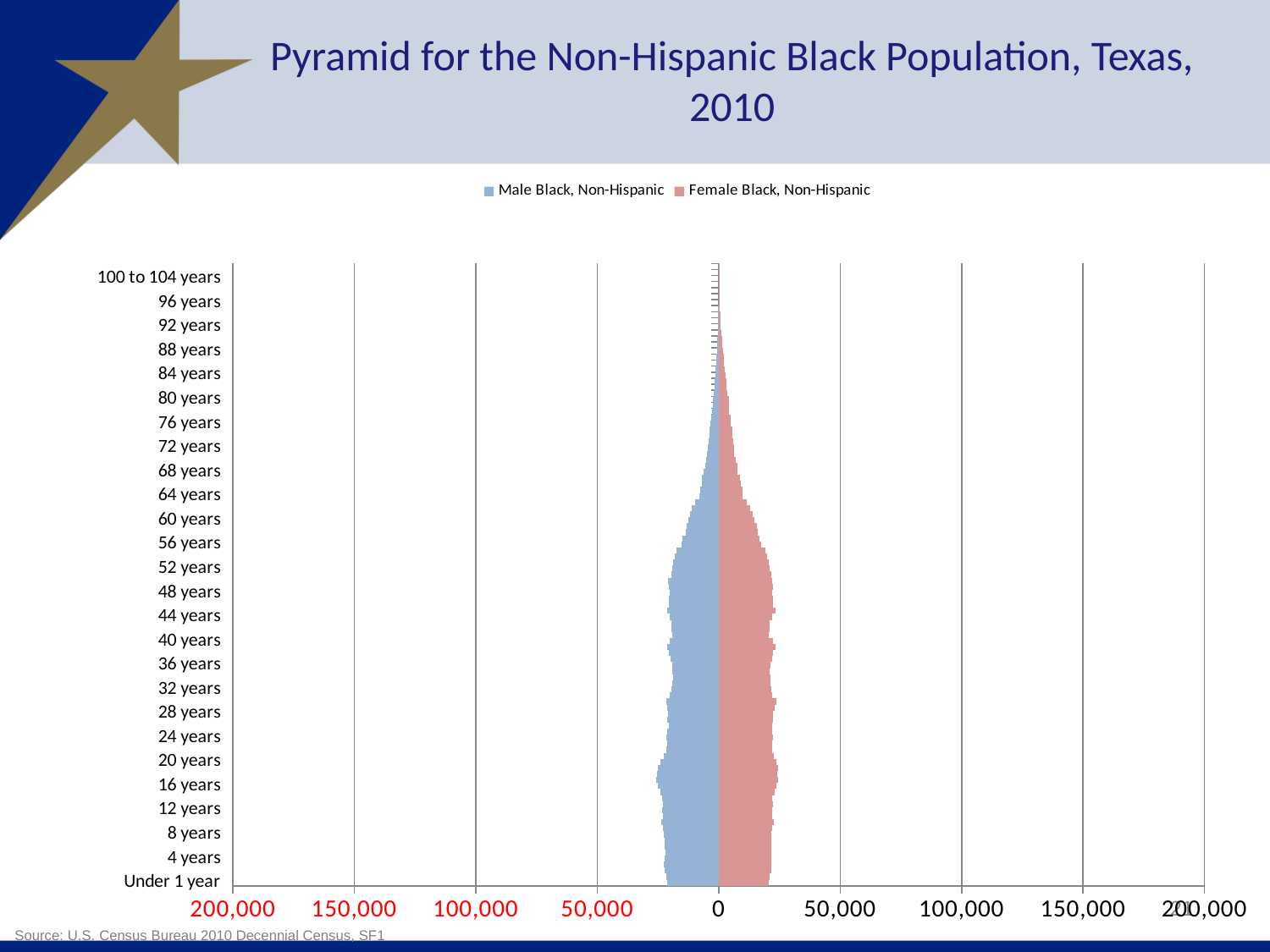
What kind of chart is shown on the slide? Bar chart (population pyramid) At 80 years, which is larger: the Male Black, Non-Hispanic value or the Female Black, Non-Hispanic value? Female Black, Non-Hispanic How many series does the legend list? 2 Moving from 60 years up to 100 to 104 years, do the Female Black, Non-Hispanic values rise or fall? fall Is the value for Male Black, Non-Hispanic at 16 years greater or less than 50,000? less What is the title of the chart? Pyramid for the Non-Hispanic Black Population, Texas, 2010 Is the value for Female Black, Non-Hispanic at 100 to 104 years greater or less than 50,000? less Which series is shown in blue? Male Black, Non-Hispanic Moving from 60 years up to 100 to 104 years, do the Male Black, Non-Hispanic values rise or fall? fall Is the value for Female Black, Non-Hispanic at 44 years greater or less than 50,000? less